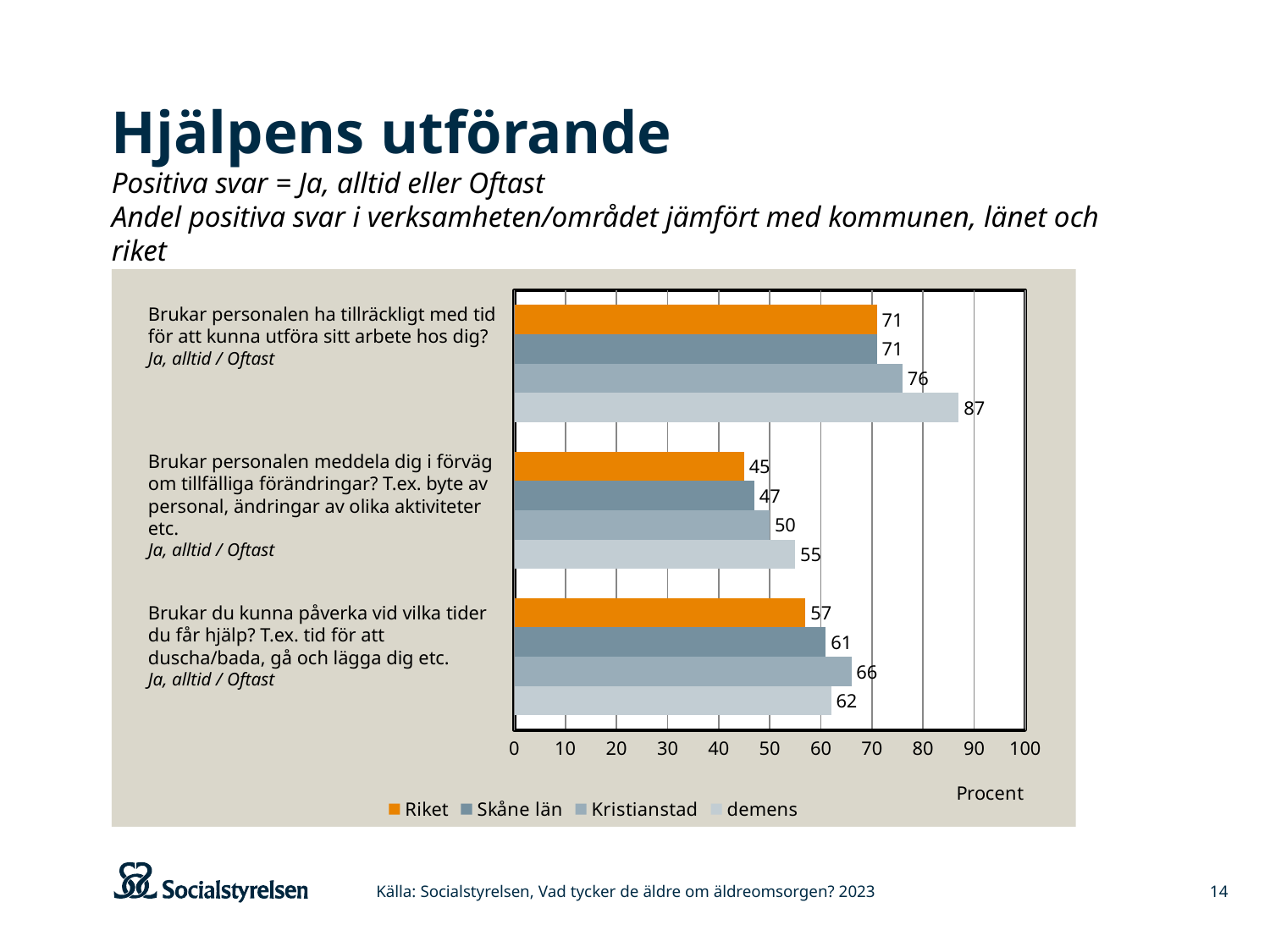
How many series does the legend list? 4 Is the value for 'Skåne län' on the question 'Brukar personalen meddela dig i förväg om tillfälliga förändringar?' greater or less than 50? less What is the value for 'Riket' on the question 'Brukar personalen meddela dig i förväg om tillfälliga förändringar?' 45 Which series has the highest value on the question 'Brukar personalen ha tillräckligt med tid för att kunna utföra sitt arbete hos dig?' demens What kind of chart is shown on the slide? Bar chart How many questions (categories) are shown in the chart? 3 Which series has the lowest value on the question 'Brukar personalen meddela dig i förväg om tillfälliga förändringar?' Riket On the question 'Brukar du kunna påverka vid vilka tider du får hjälp?', which is larger: the value for 'Kristianstad' or the value for 'demens'? Kristianstad What is the difference between the 'demens' value and the 'Riket' value on the question 'Brukar personalen ha tillräckligt med tid för att kunna utföra sitt arbete hos dig?' 16 What unit is shown on the x axis of the chart? Procent What is the value for 'demens' on the question 'Brukar personalen ha tillräckligt med tid för att kunna utföra sitt arbete hos dig?' 87 What is the value for 'Kristianstad' on the question 'Brukar du kunna påverka vid vilka tider du får hjälp?' 66